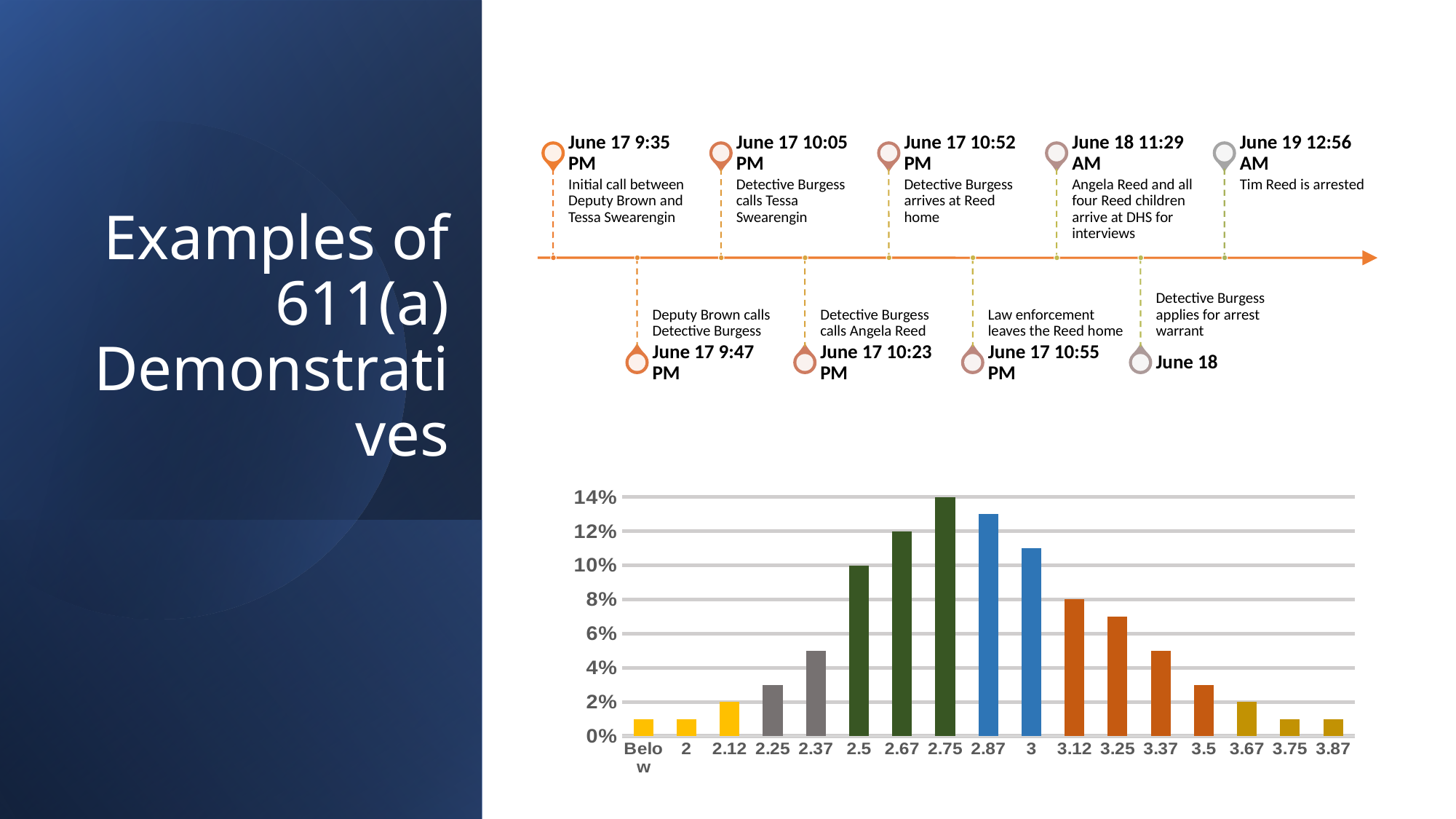
In the bar chart, is the value for 3.25 greater or less than 8%? less What kind of chart is shown at the bottom of the slide? bar chart In the bar chart, what is the value for 2.67? 12% In the bar chart, what is the value for 3.12? 8% In the bar chart, what is the difference between the values for 2.75 and 2.5? 4% In the bar chart, which is larger, the value for 2.5 or the value for 3.12? 2.5 In the bar chart, what is the value for 2.75? 14% In the bar chart, what is the value for 2.5? 10% In the bar chart, do the values rise or fall from 2.75 to 3.87 along the x axis? fall In the bar chart, how many categories are shown on the x axis? 17 In the bar chart, which category has the highest value? 2.75 In the bar chart, is the value for 2.37 greater or less than 4%? greater